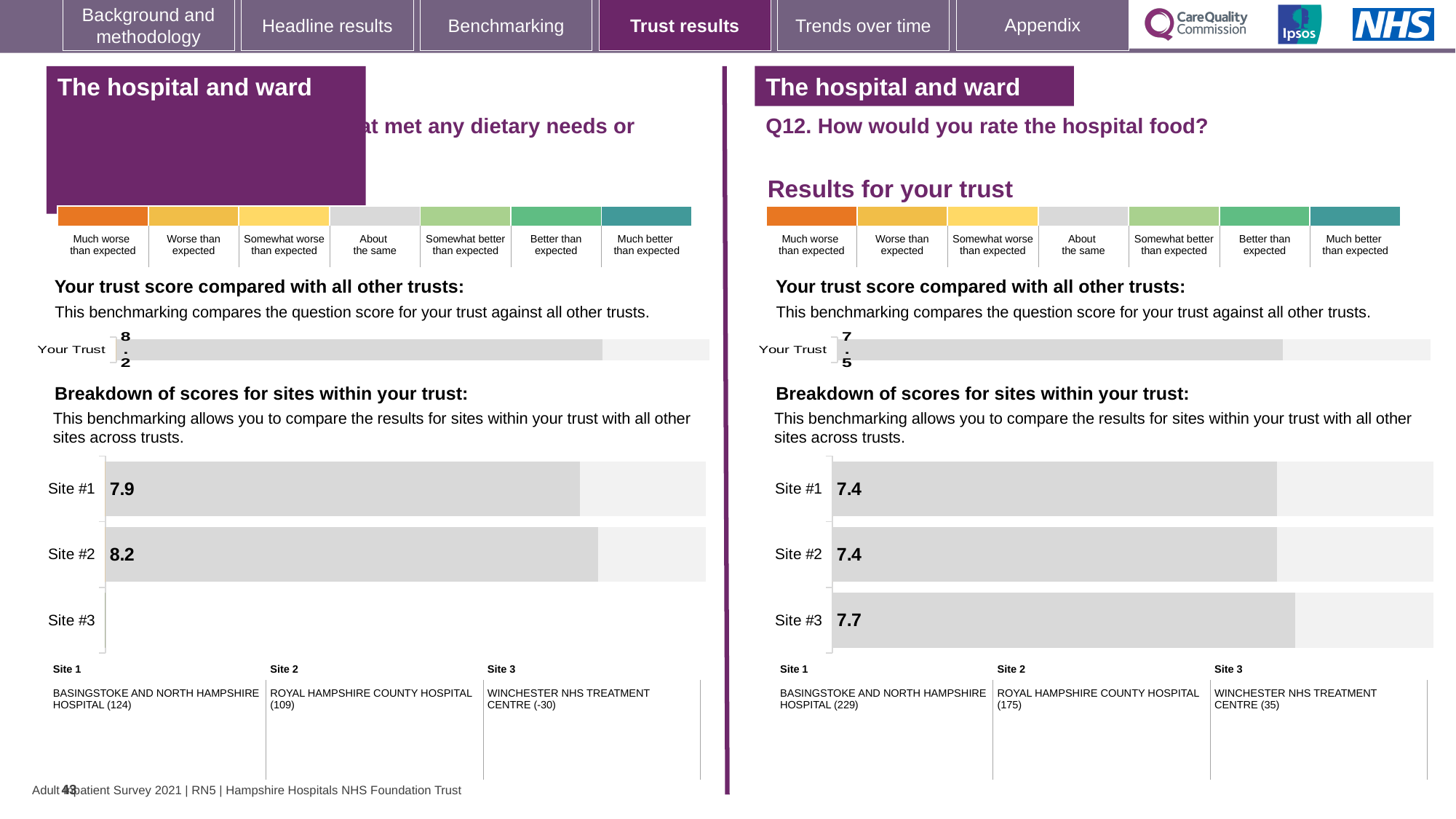
On the right-hand chart (Q12. How would you rate the hospital food?), what is the score for Site #3? 7.7 On the left-hand chart (breakdown of scores for sites within your trust), what is the score for Site #2? 8.2 On the left-hand chart (breakdown of scores for sites within your trust), what is the score for Site #1? 7.9 On the left-hand chart, what is the 'Your Trust' score compared with all other trusts? 8.2 On the left-hand chart (breakdown of scores for sites within your trust), what is the difference between the scores for Site #2 and Site #1? 0.3 On the left-hand chart (breakdown of scores for sites within your trust), which is larger, the score for Site #1 or Site #2? Site #2 What type of chart is used for the breakdown of scores for sites within your trust on the right-hand side? Bar chart On the right-hand chart (Q12. How would you rate the hospital food?), which site has the highest score? Site #3 On the right-hand chart (Q12. How would you rate the hospital food?), what is the difference between the scores for Site #3 and Site #1? 0.3 On the right-hand chart (Q12. How would you rate the hospital food?), what is the 'Your Trust' score? 7.5 On the right-hand chart (Q12. How would you rate the hospital food?), how many sites are shown in the breakdown? 3 On the right-hand chart (Q12. How would you rate the hospital food?), what is the score for Site #1? 7.4